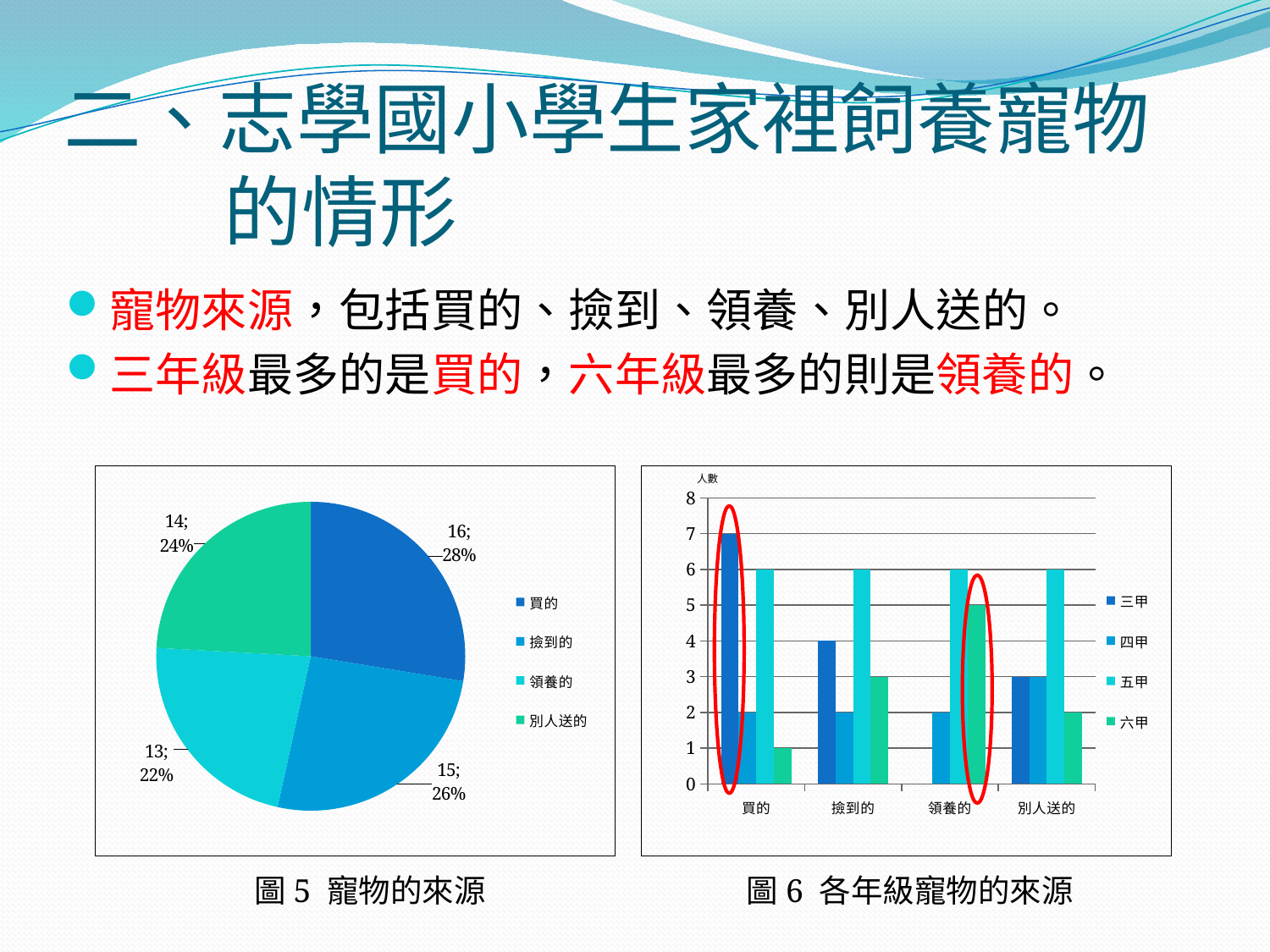
In the pie chart 圖 5 寵物的來源, what share of the pie does 領養的 have? 22% In the pie chart 圖 5 寵物的來源, what value and percentage are shown for 買的? 16; 28% What kind of chart is 圖 6 各年級寵物的來源? Bar chart In the bar chart 圖 6 各年級寵物的來源, which is larger in the 撿到的 category: 三甲 or 六甲? 三甲 In the bar chart 圖 6 各年級寵物的來源, what is the value for 六甲 in the 領養的 category? 5 In the pie chart 圖 5 寵物的來源, which category has the largest slice? 買的 In the bar chart 圖 6 各年級寵物的來源, what is the difference between 五甲 and 六甲 in the 買的 category? 5 In the bar chart 圖 6 各年級寵物的來源, what is the value for 三甲 in the 買的 category? 7 In the pie chart 圖 5 寵物的來源, which category has the smallest slice? 領養的 In the bar chart 圖 6 各年級寵物的來源, how many series does the legend list? 4 In the pie chart 圖 5 寵物的來源, how many categories does the legend list? 4 What kind of chart is 圖 5 寵物的來源? Pie chart